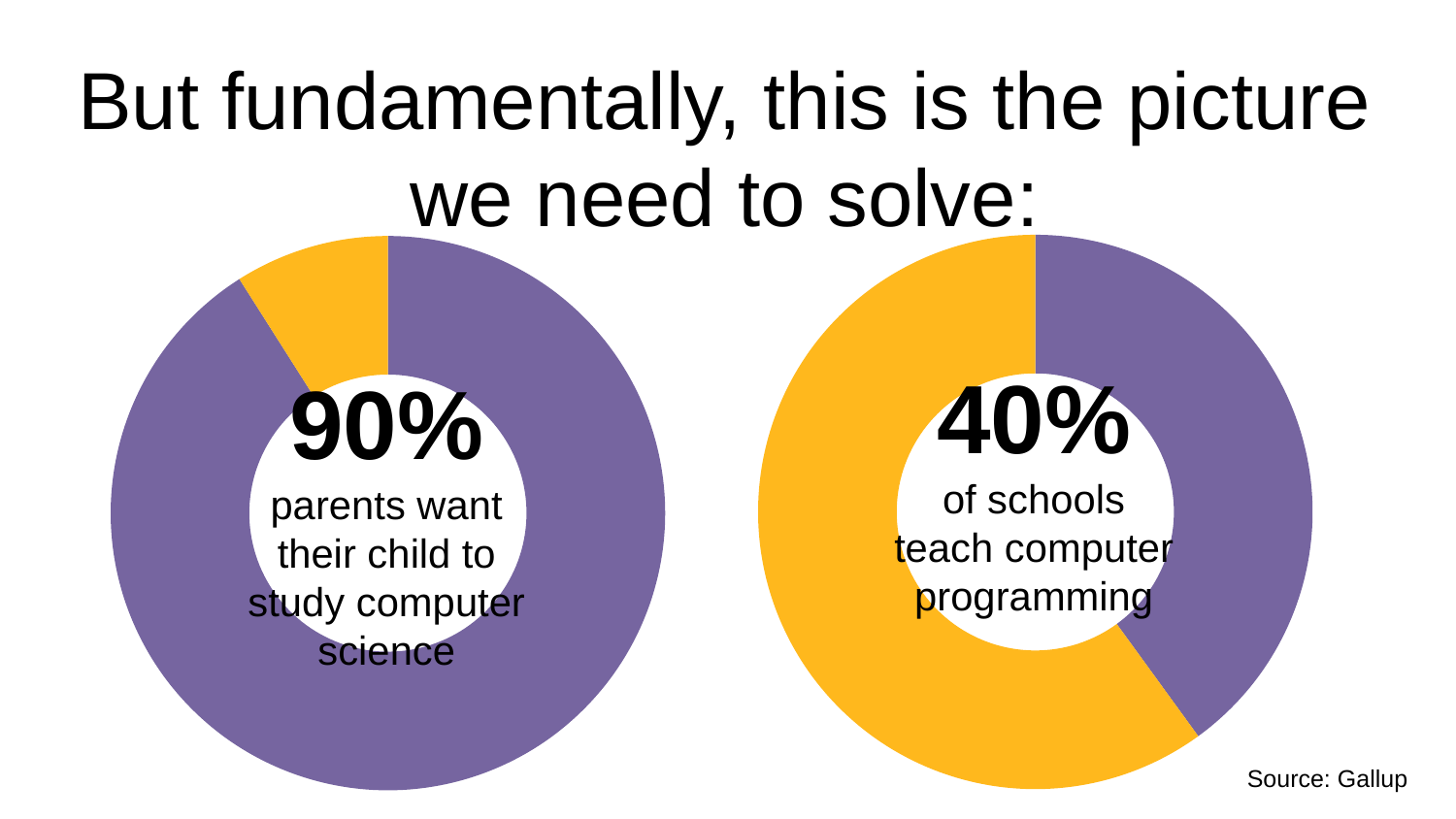
What kind of chart is used on the left of the slide? Donut (pie) chart How many slices does the right chart have? 2 In the right chart, what percentage of schools teach computer programming? 40% What kind of chart is used on the right of the slide? Donut (pie) chart What source is cited for the data on the slide? Gallup In the left chart, what percentage of parents want their child to study computer science? 90% In the left chart, what share of the donut is the yellow slice, given the purple slice is 90%? 10% What is the difference between the percentage shown in the left chart (90%) and the percentage shown in the right chart (40%)? 50 percentage points What colour is the slice representing the 90% of parents in the left chart? Purple How many slices does the left chart have? 2 Which is larger: the percentage of parents who want their child to study computer science (left chart) or the percentage of schools that teach computer programming (right chart)? Parents who want their child to study computer science (90%) In the right chart, what share of the donut is the yellow slice, given the purple slice is 40%? 60%